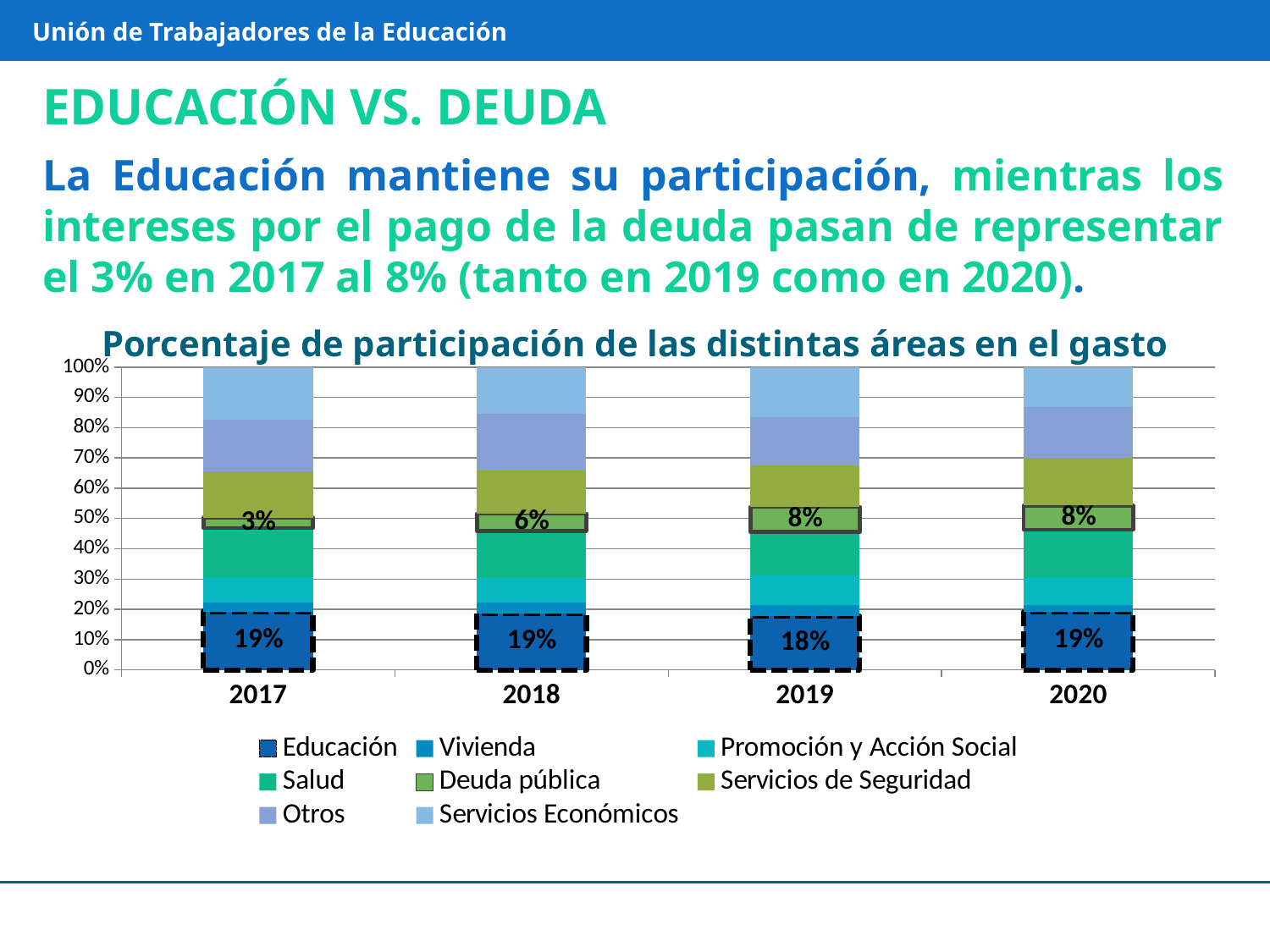
In which year is the Deuda pública share lowest? 2017 What is the value for Deuda pública in 2019? 8% What is the value for Educación in 2019? 18% What kind of chart is shown on the slide? Stacked bar chart How many series does the legend list? 8 By how many percentage points did the Deuda pública share change from 2017 to 2020? 5 percentage points What is the value for Deuda pública in 2017? 3% In which year is the Educación share lowest? 2019 What is the value for Educación in 2017? 19% Does the Deuda pública share rise or fall from 2017 to 2020? Rise How many years are shown on the x axis? 4 In 2018, which is larger: the Educación share or the Deuda pública share? Educación